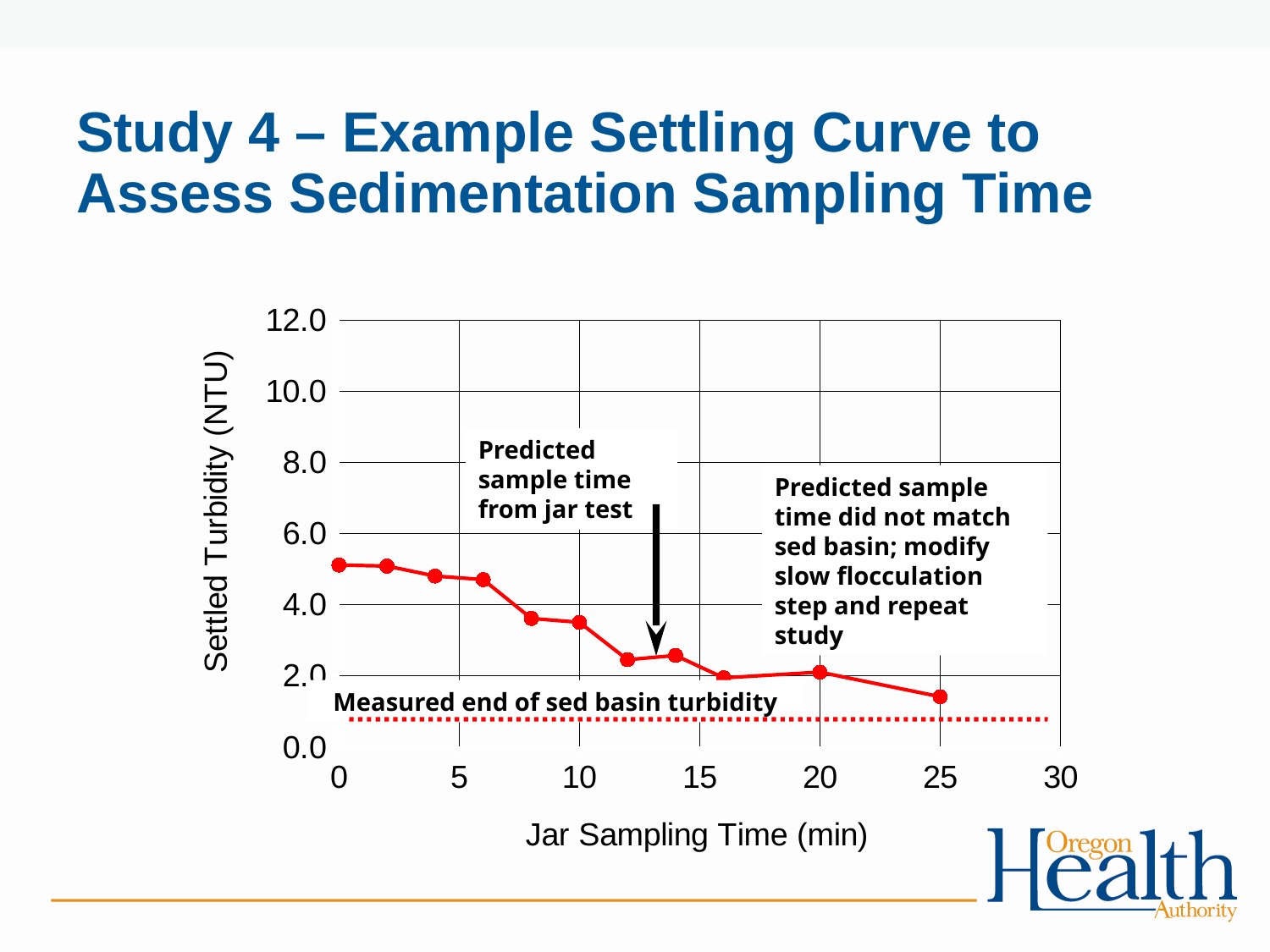
Is the settled turbidity at 6 min greater or less than 4.0 NTU? greater Is the settled turbidity at 25 min greater or less than 2.0 NTU? less At which jar sampling time is the settled turbidity lowest? 25 min What kind of chart is shown on the slide? line chart Is the settled turbidity at 0 min greater or less than 4.0 NTU? greater Which has the larger settled turbidity, the point at 0 min or the point at 25 min? 0 min What is the title of the x axis? Jar Sampling Time (min) Do the settled turbidity values rise or fall as jar sampling time increases? fall How many data points are plotted on the settling curve? 11 What does the dotted red line near the bottom of the chart represent? Measured end of sed basin turbidity